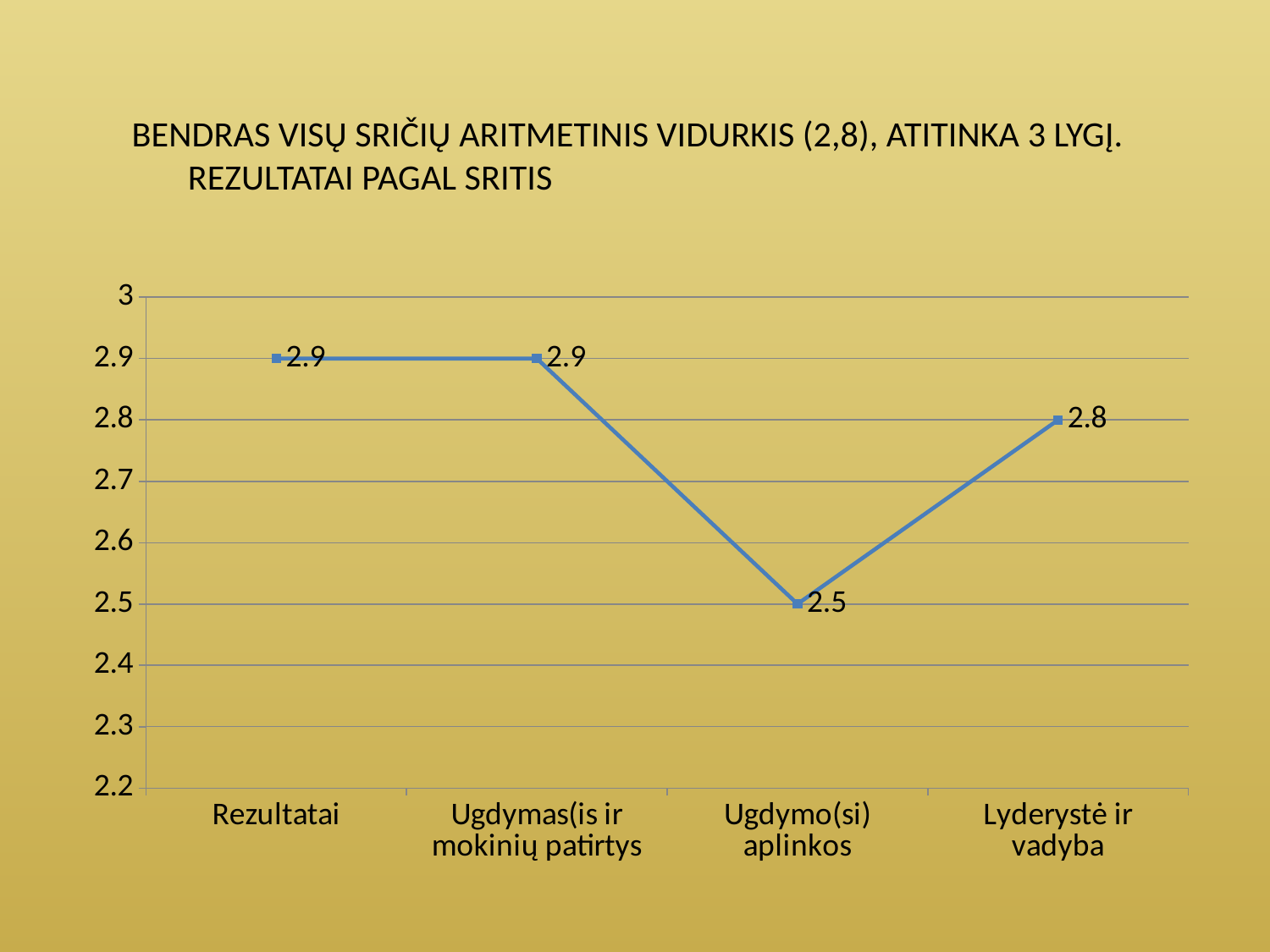
What is the value for Ugdymo(si) aplinkos? 2.5 Is the value for Ugdymo(si) aplinkos greater or less than 2.7? less Which is larger, the value for Rezultatai or the value for Lyderystė ir vadyba? Rezultatai What is the value for Rezultatai? 2.9 What is the difference between the values for Lyderystė ir vadyba and Ugdymo(si) aplinkos? 0.3 What is the value for Ugdymas(is ir mokinių patirtys? 2.9 Does the value rise or fall from Ugdymo(si) aplinkos to Lyderystė ir vadyba? rise What is the value for Lyderystė ir vadyba? 2.8 What kind of chart is shown on the slide? line chart Which category has the lowest value? Ugdymo(si) aplinkos What is the difference between the values for Rezultatai and Ugdymo(si) aplinkos? 0.4 How many categories are shown on the x axis? 4